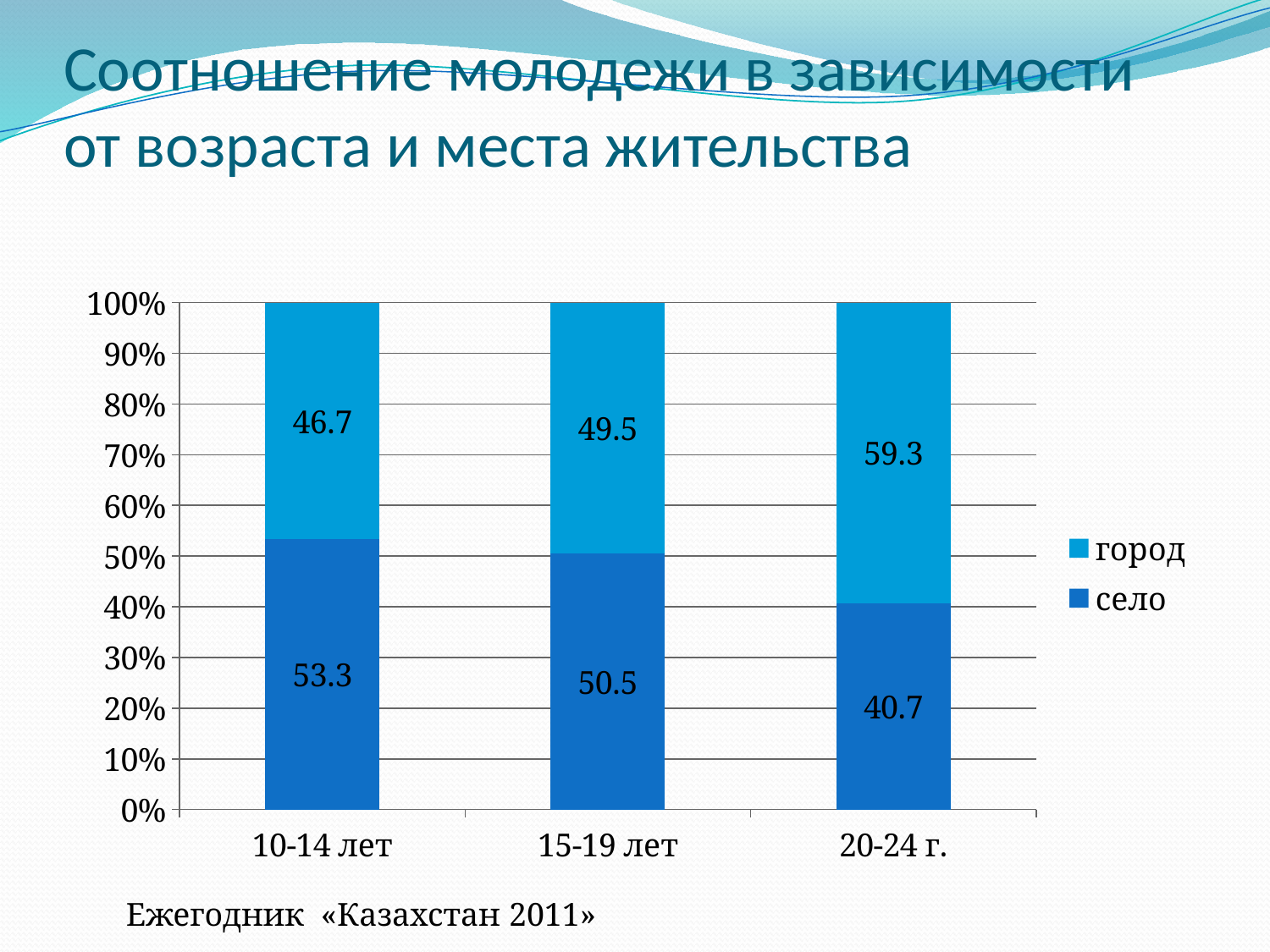
What kind of chart is shown on the slide? stacked bar chart What is the value for село in the 10-14 лет category? 53.3 How many series does the legend list? 2 How many age categories are shown on the x axis? 3 Which age category has the lowest value for село? 20-24 г. In the 10-14 лет category, which is larger: город or село? село Which age category has the highest value for город? 20-24 г. What is the value for город in the 15-19 лет category? 49.5 What is the difference between the город and село values in the 20-24 г. category? 18.6 Do the values for село rise or fall from 10-14 лет to 20-24 г.? fall What source is cited below the chart? Ежегодник «Казахстан 2011» What is the value for город in the 20-24 г. category? 59.3